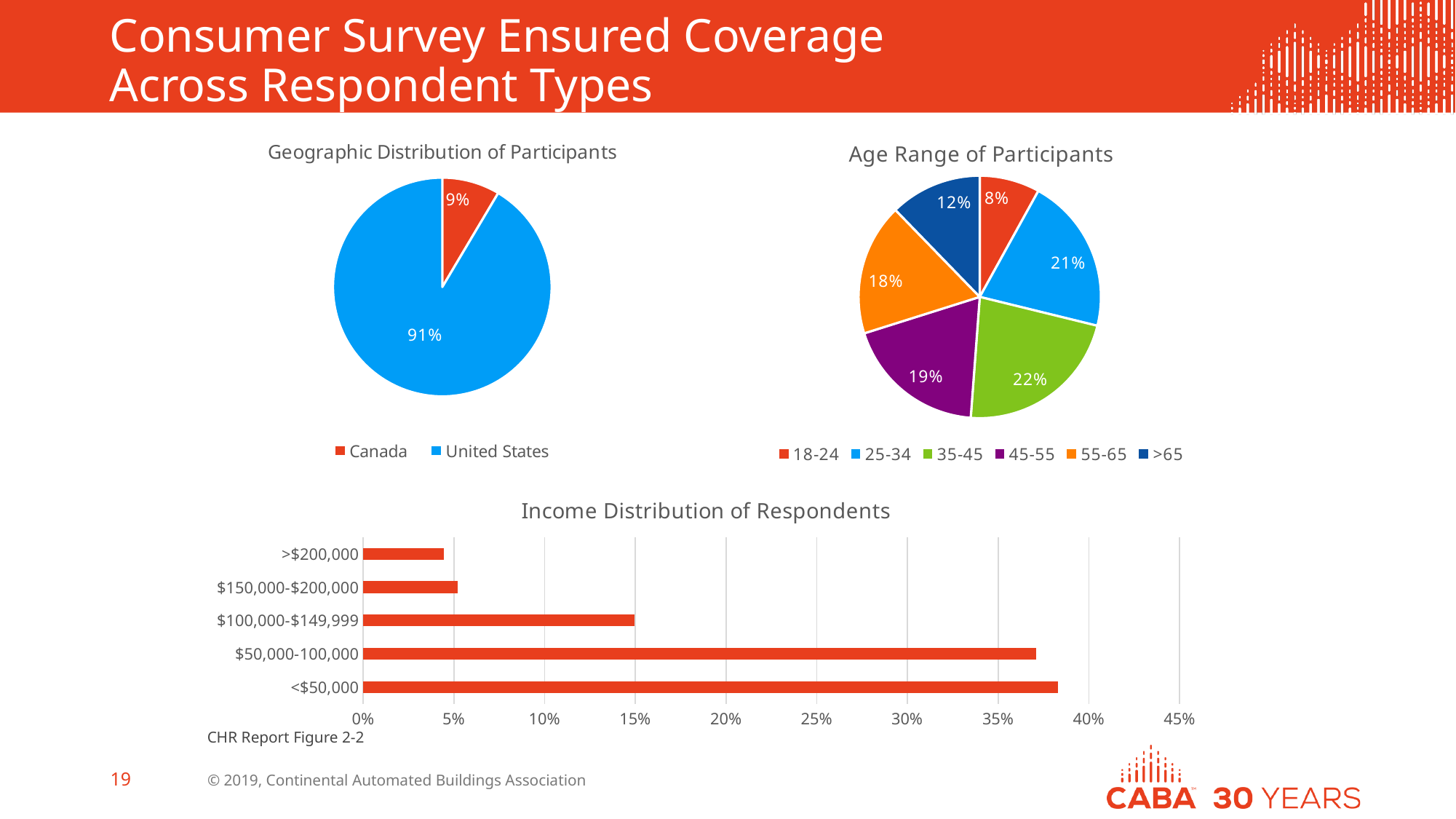
In the Income Distribution of Respondents chart, how many income categories are shown? 5 In the Income Distribution of Respondents chart, is the value for $100,000-$149,999 greater or less than 10%? greater In the Geographic Distribution of Participants chart, what share of participants are from the United States? 91% In the Age Range of Participants chart, which age range has the smallest share? 18-24 In the Geographic Distribution of Participants chart, what share of participants are from Canada? 9% In the Age Range of Participants chart, how many age ranges does the legend list? 6 In the Age Range of Participants chart, what is the difference between the 25-34 share and the >65 share? 9% What kind of chart is the Income Distribution of Respondents chart? bar chart In the Age Range of Participants chart, which age range has the largest share? 35-45 In the Income Distribution of Respondents chart, which income category has the highest value? <$50,000 In the Income Distribution of Respondents chart, which is larger, the value for >$200,000 or the value for $150,000-$200,000? $150,000-$200,000 In the Age Range of Participants chart, what share of participants are aged 35-45? 22%